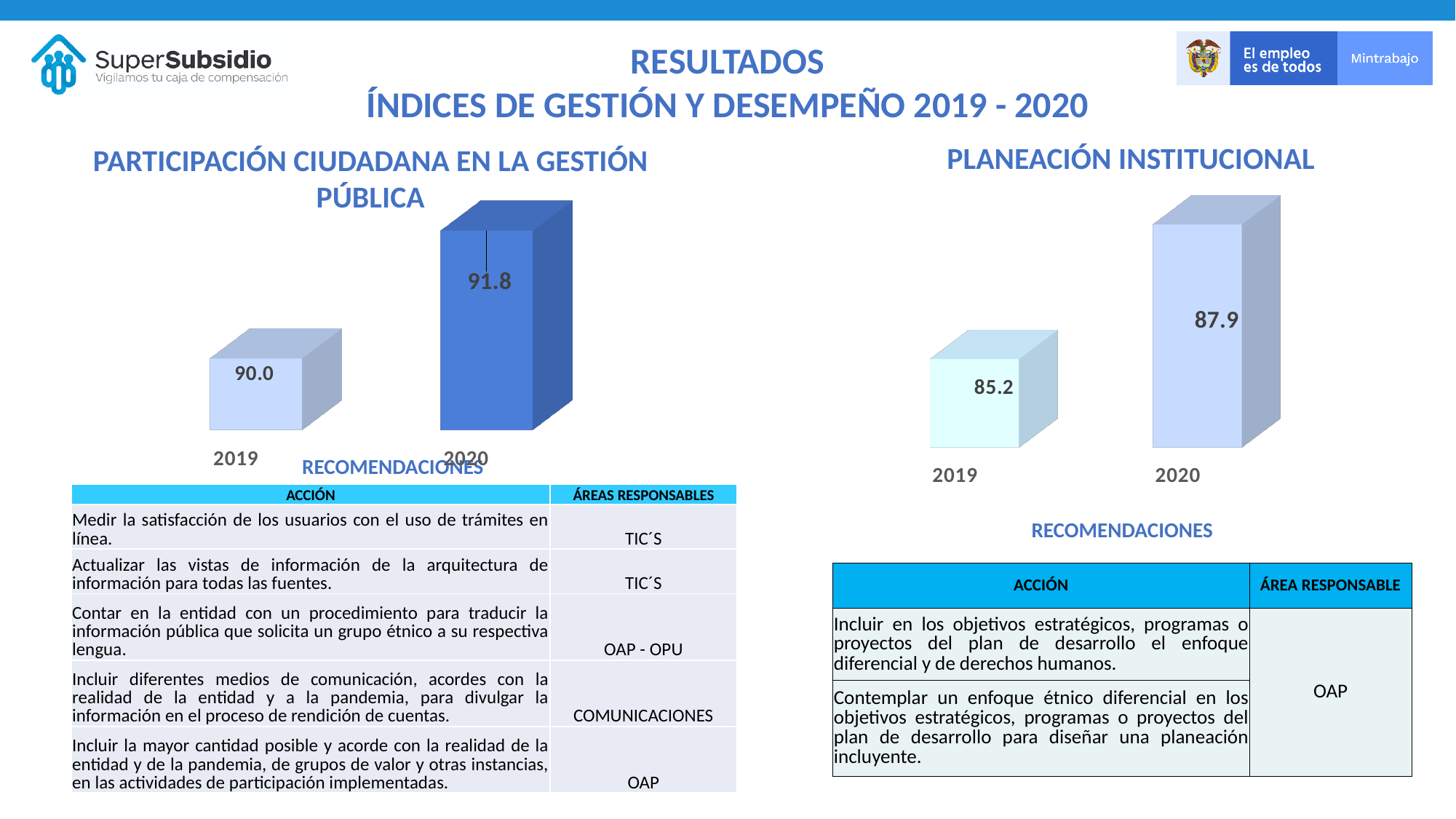
In the 'Participación ciudadana en la gestión pública' chart, what is the value for 2019? 90.0 In the 'Planeación institucional' chart, what is the value for 2020? 87.9 How many bars are shown in the 'Participación ciudadana en la gestión pública' chart? 2 In the 'Planeación institucional' chart, is the value for 2020 larger or smaller than the value for 2019? larger In the 'Participación ciudadana en la gestión pública' chart, do the values rise or fall from 2019 to 2020? rise In the 'Participación ciudadana en la gestión pública' chart, what is the value for 2020? 91.8 In the 'Planeación institucional' chart, which year has the lower value? 2019 What type of chart is the 'Planeación institucional' chart? bar chart In the 'Participación ciudadana en la gestión pública' chart, what is the difference between the 2020 and 2019 values? 1.8 In the 'Planeación institucional' chart, what is the difference between the 2020 and 2019 values? 2.7 In the 'Planeación institucional' chart, what is the value for 2019? 85.2 In the 'Participación ciudadana en la gestión pública' chart, which year has the higher value? 2020